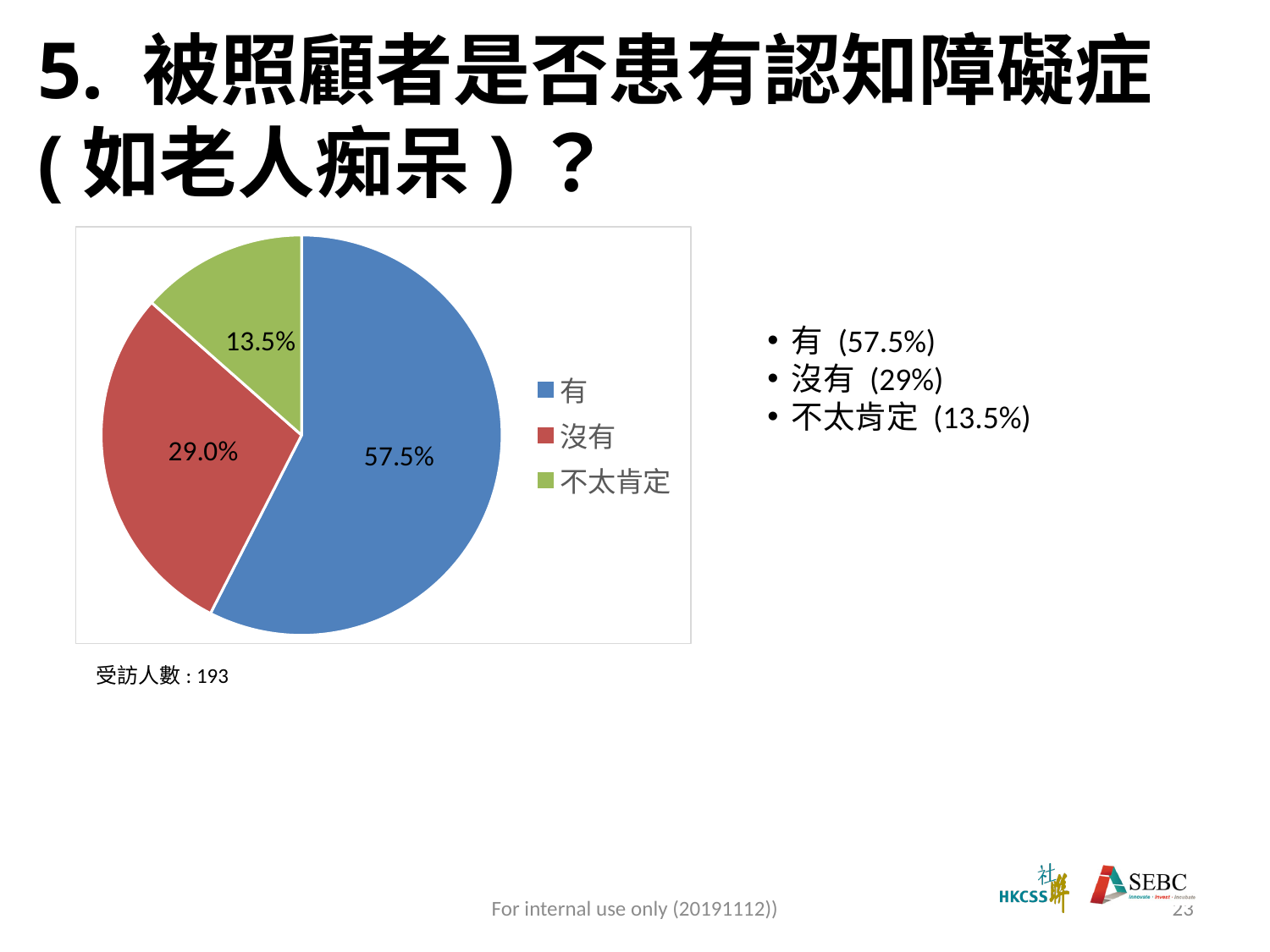
What kind of chart is shown on the slide? pie chart What is the value for 沒有 in the pie chart? 29.0% How many categories does the pie chart have? 3 What is the difference between the shares for 沒有 and 不太肯定? 15.5% What colour is the slice for 沒有? red What is the value for 不太肯定 in the pie chart? 13.5% How many entries does the legend list? 3 What is the value for 有 in the pie chart? 57.5% What is the difference between the shares for 有 and 沒有? 28.5% Which category has the largest share of the pie? 有 Which category has the smallest share of the pie? 不太肯定 Which is larger, the share for 沒有 or the share for 不太肯定? 沒有